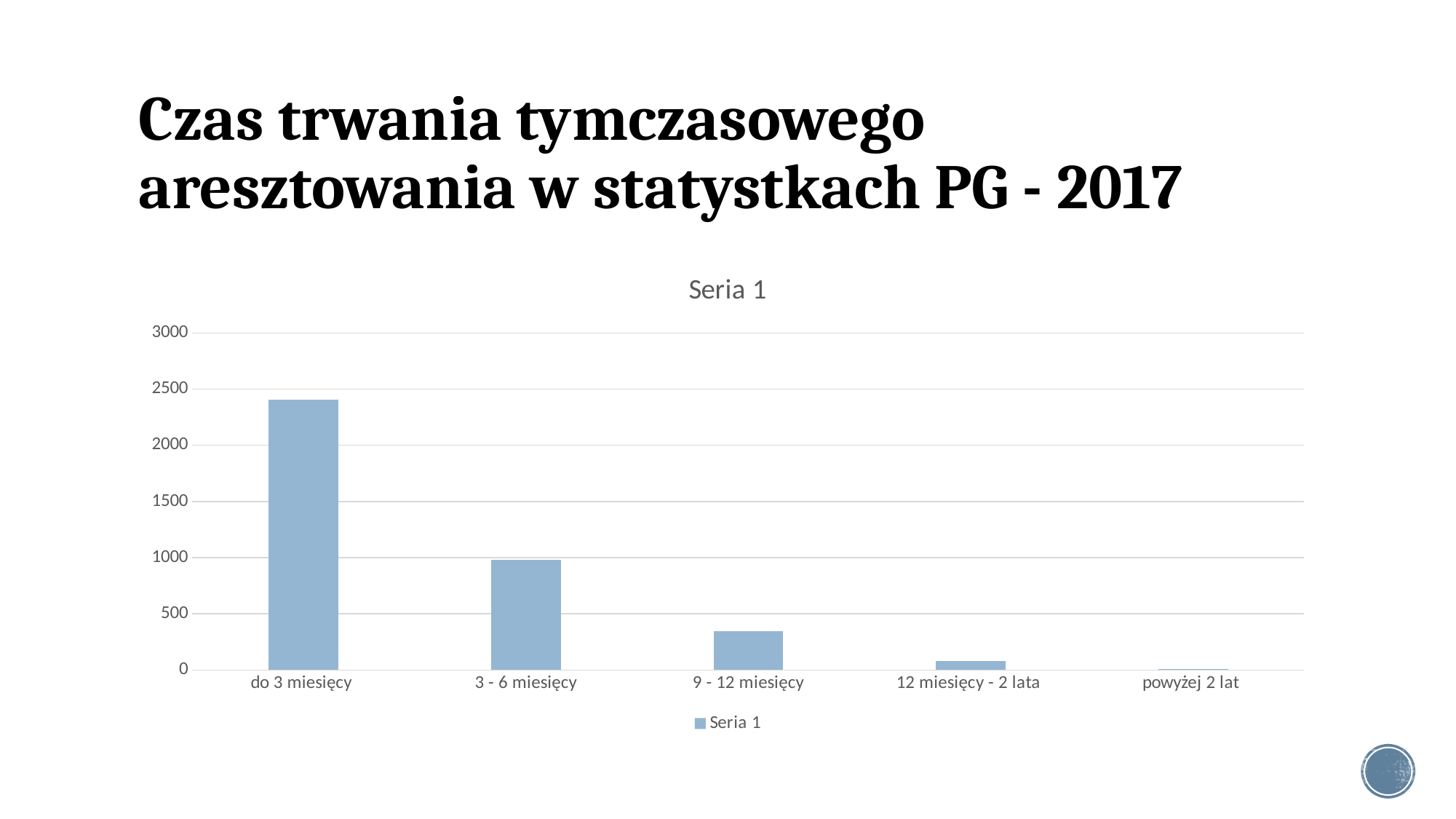
Which category has the highest value in the chart? do 3 miesięcy Which category has the lowest value in the chart? powyżej 2 lat How many series does the chart legend list? 1 Do the values rise or fall moving from left to right along the x axis? fall Is the value for 9 - 12 miesięcy greater or less than 500? less Which is larger, the value for 3 - 6 miesięcy or the value for 9 - 12 miesięcy? 3 - 6 miesięcy What is the title of the chart? Seria 1 What is the highest value shown on the vertical axis of the chart? 3000 What kind of chart is shown on the slide? bar chart Is the value for do 3 miesięcy greater or less than 2000? greater How many categories are shown on the x axis of the chart? 5